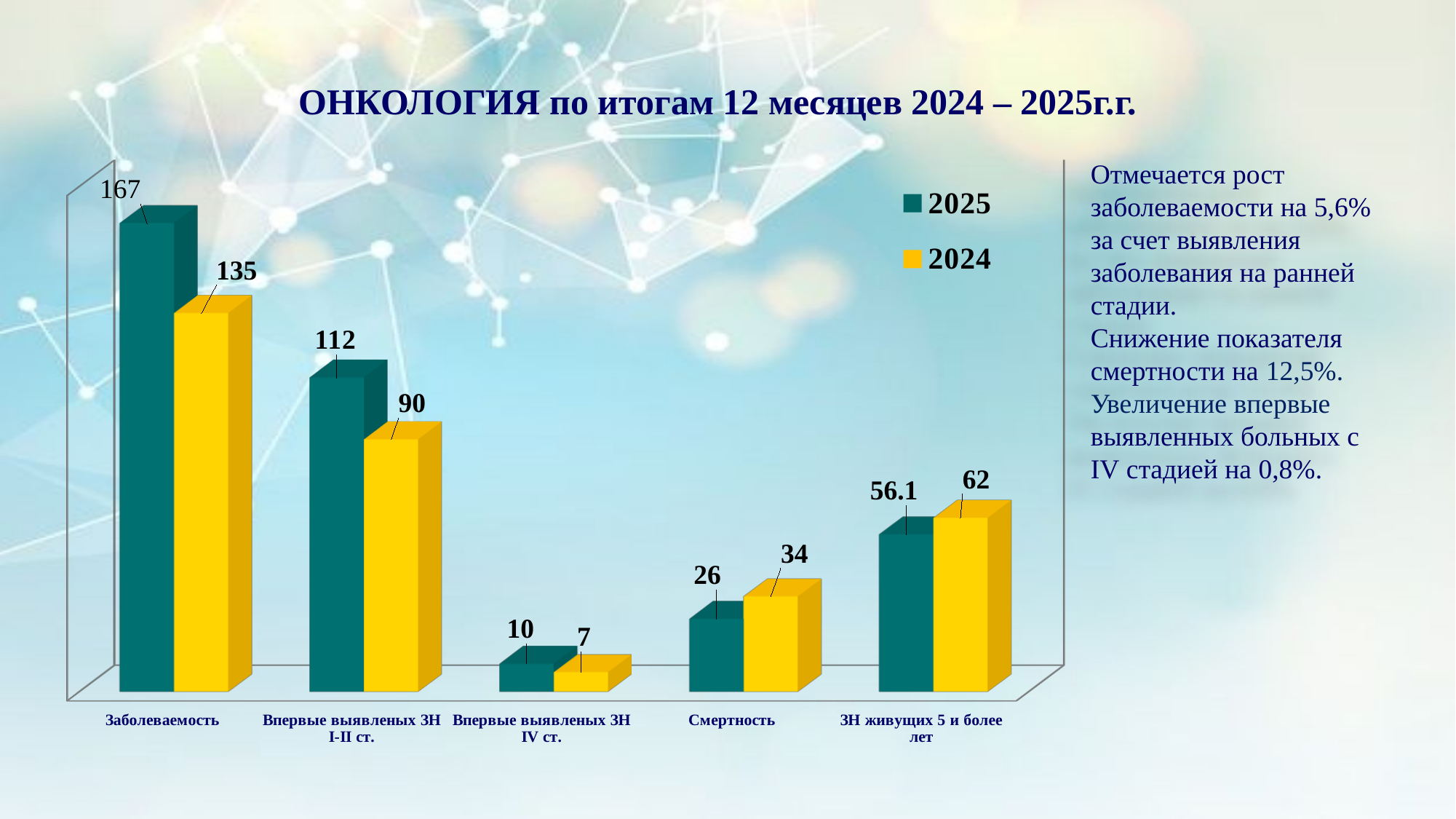
Which category has the lowest value in the 2024 series? Впервые выявленых ЗН IV ст. Which colour represents the 2024 series in the legend? Yellow How many series does the legend list? 2 How many categories are shown on the x axis? 5 What is the value for Смертность in the 2024 series? 34 Which category has the highest value in the 2025 series? Заболеваемость What kind of chart is shown on the slide? Bar chart What is the difference between the 2025 and 2024 values for Впервые выявленых ЗН I-II ст.? 22 What is the value for Впервые выявленых ЗН IV ст. in the 2024 series? 7 What is the value for ЗН живущих 5 и более лет in the 2025 series? 56.1 Which is larger for Смертность: the 2025 value or the 2024 value? 2024 What is the value for Заболеваемость in the 2025 series? 167